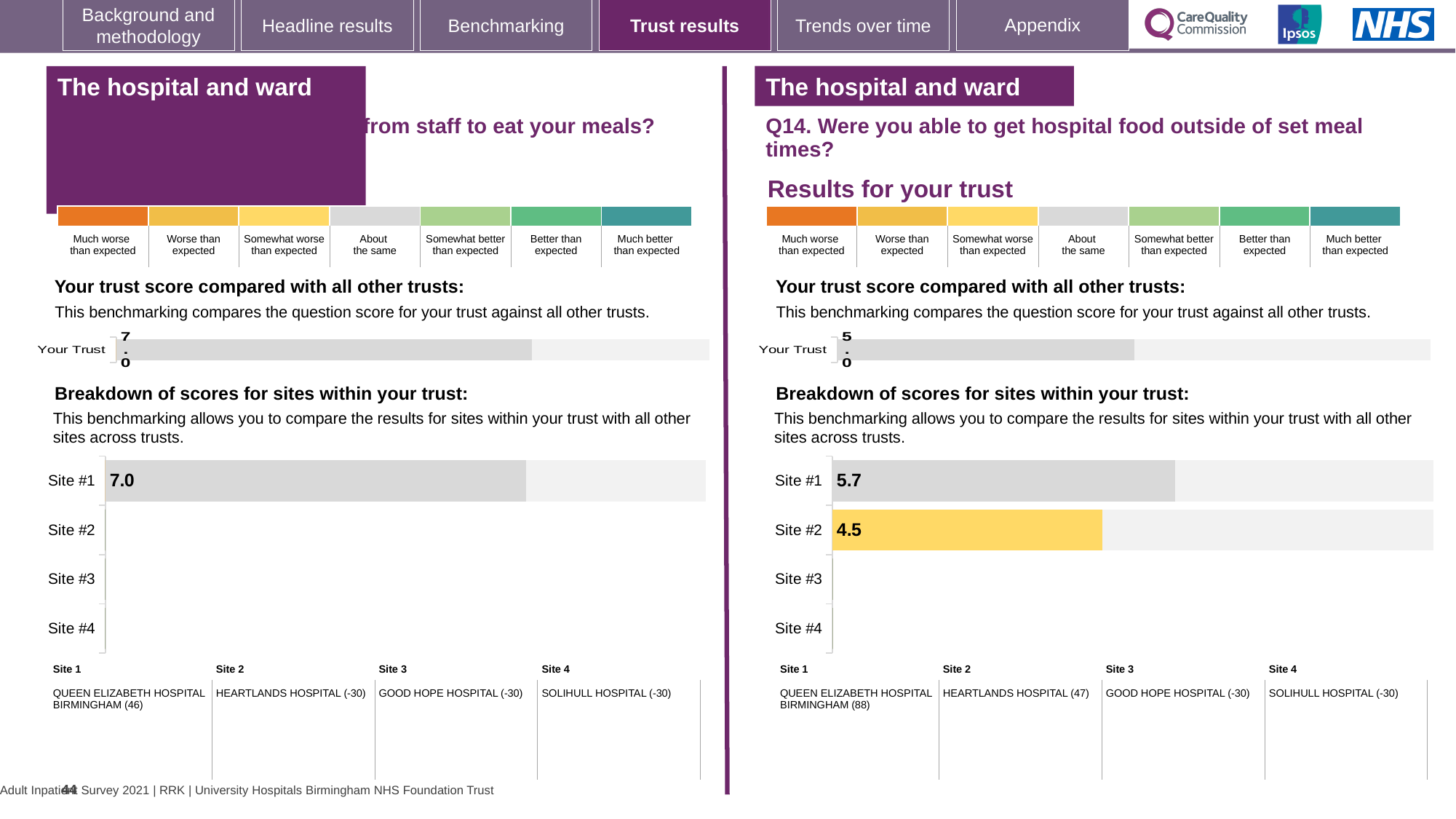
On the left-hand 'Breakdown of scores for sites within your trust' chart, what is the score for Site #1? 7.0 What type of chart is used for the 'Breakdown of scores for sites within your trust' on the right-hand side? Bar chart On the left-hand 'Your trust score compared with all other trusts' chart, what is the score for Your Trust? 7.0 On the right-hand Q14 breakdown chart, which site has the highest score shown? Site #1 On the right-hand Q14 breakdown chart, which site has the higher score, Site #1 or Site #2? Site #1 On the right-hand Q14 breakdown chart, what is the difference between the Site #1 and Site #2 scores? 1.2 On the right-hand 'Breakdown of scores for sites within your trust' chart (Q14), what is the score for Site #1? 5.7 On the right-hand 'Your trust score compared with all other trusts' chart (Q14), what is the score for Your Trust? 5.0 Which is higher: the Your Trust score on the left-hand chart or the Your Trust score on the right-hand Q14 chart? The left-hand chart (7.0) On the right-hand 'Breakdown of scores for sites within your trust' chart (Q14), what is the score for Site #2? 4.5 On the right-hand Q14 breakdown chart, what colour is the bar for Site #2? Yellow How many site categories are listed on the right-hand Q14 breakdown chart? 4